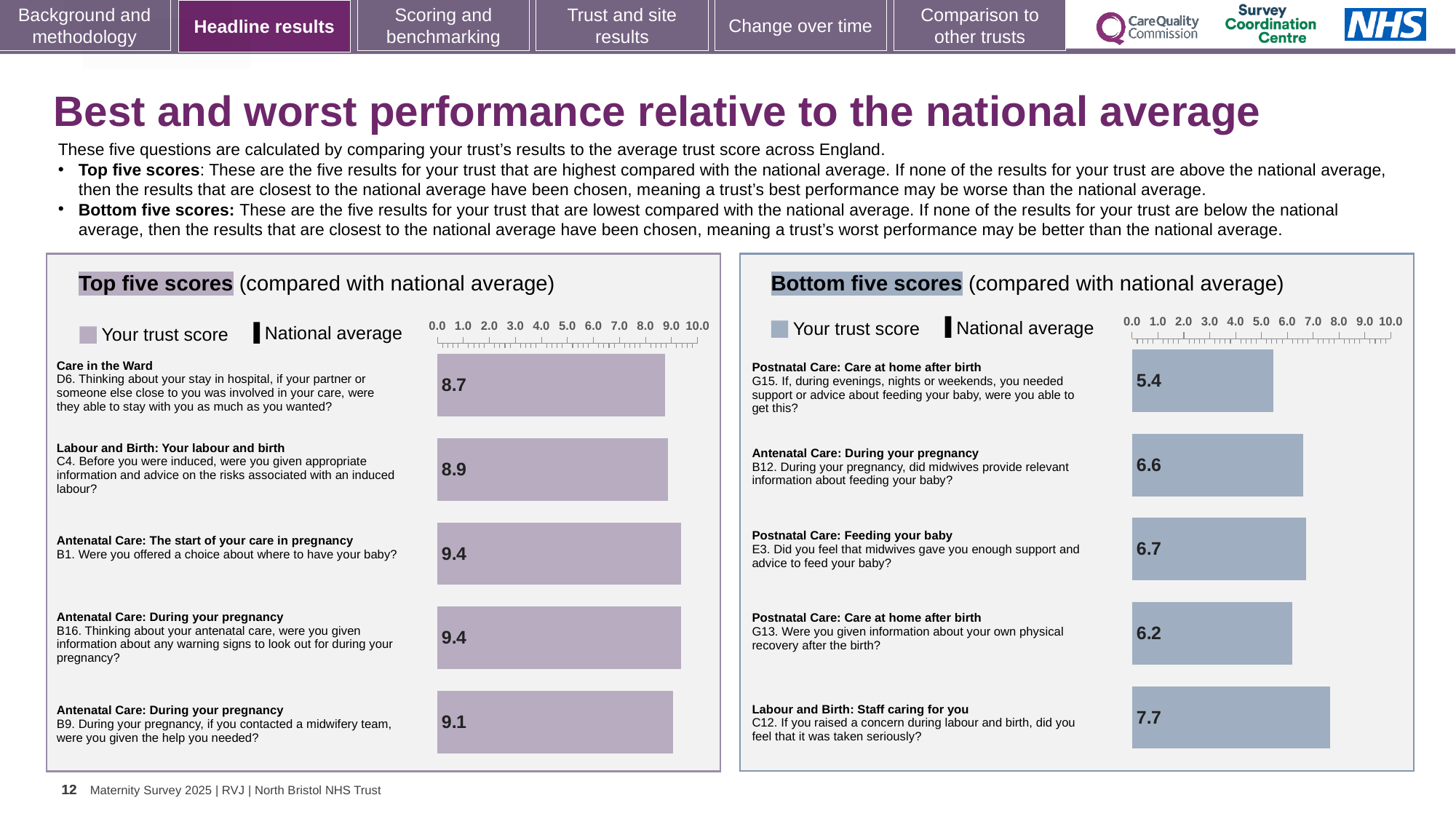
In the Bottom five scores chart, what is the trust score for C12 (concern raised during labour and birth taken seriously)? 7.7 In the Top five scores chart, what is the trust score for C4 (information and advice on the risks of an induced labour)? 8.9 In the Bottom five scores chart, what is the difference between the trust scores for C12 and G15? 2.3 What kind of chart is used in the Top five scores panel? Bar chart In the Bottom five scores chart, which question has the lowest trust score? G15 In the Bottom five scores chart, which question has the highest trust score? C12 In the Top five scores chart, what is the trust score for B9 (given the help you needed when contacting a midwifery team)? 9.1 In the Top five scores chart, which has the larger trust score, C4 or B9? B9 How many questions are shown in the Bottom five scores chart? 5 In the Top five scores chart, what is the trust score for D6 (partner or someone close able to stay with you as much as you wanted)? 8.7 In the Top five scores chart, which question has the lowest trust score? D6 In the Bottom five scores chart, what is the trust score for G15 (support or advice about feeding your baby during evenings, nights or weekends)? 5.4